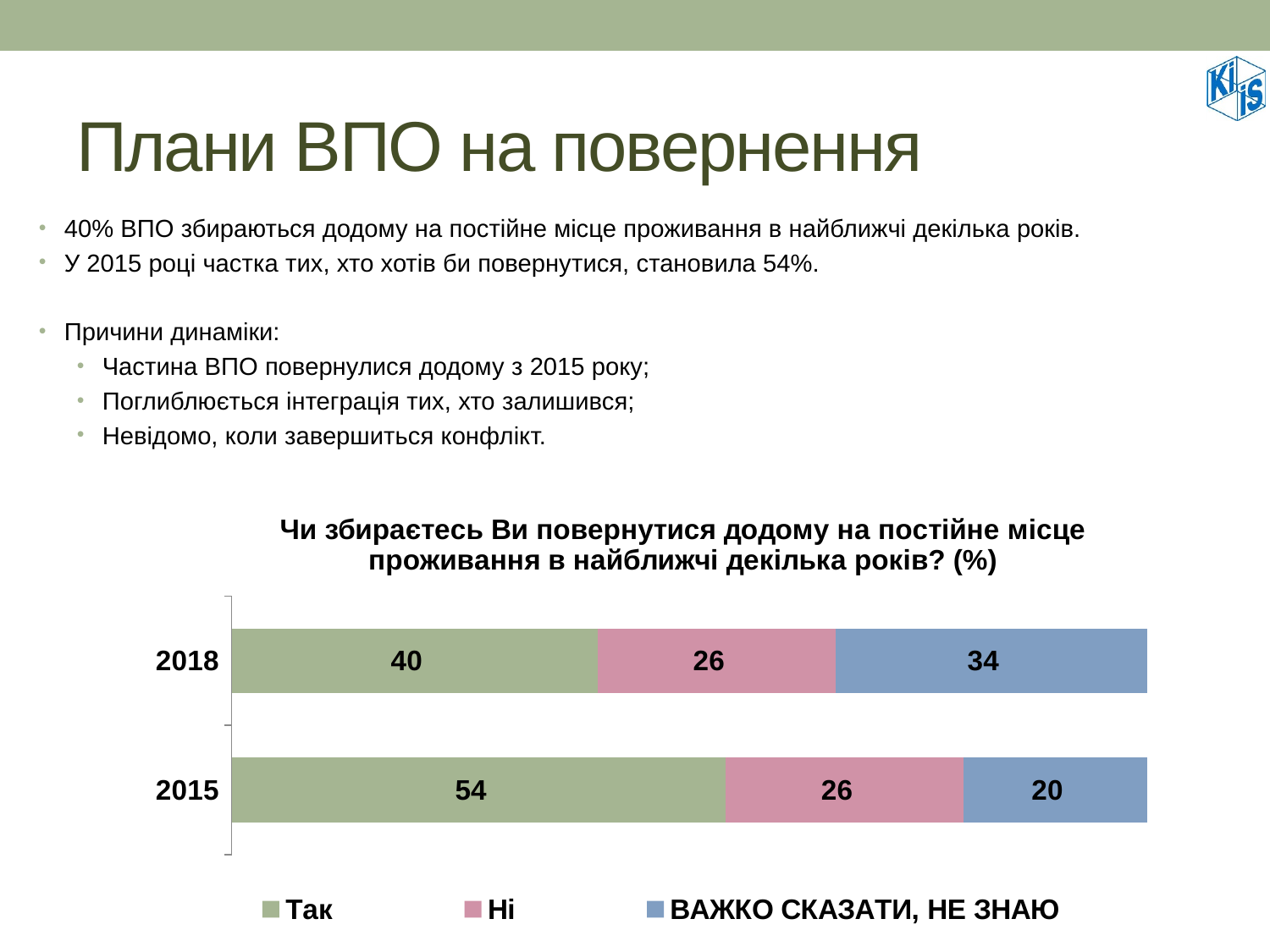
Which year has the higher "Так" value? 2015 What is the value for "Ні" in 2015? 26 What is the value for "Так" in 2018? 40 What is the total of the stacked bar for 2018? 100 What kind of chart is shown on the slide? Stacked bar chart What is the value for "Так" in 2015? 54 What is the value for "ВАЖКО СКАЗАТИ, НЕ ЗНАЮ" in 2018? 34 Which year has the larger "ВАЖКО СКАЗАТИ, НЕ ЗНАЮ" value, 2015 or 2018? 2018 How many series does the legend list? 3 What is the difference between the "Так" values for 2015 and 2018? 14 How many years (categories) are shown in the chart? 2 Which colour represents "Ні" in the chart? Pink